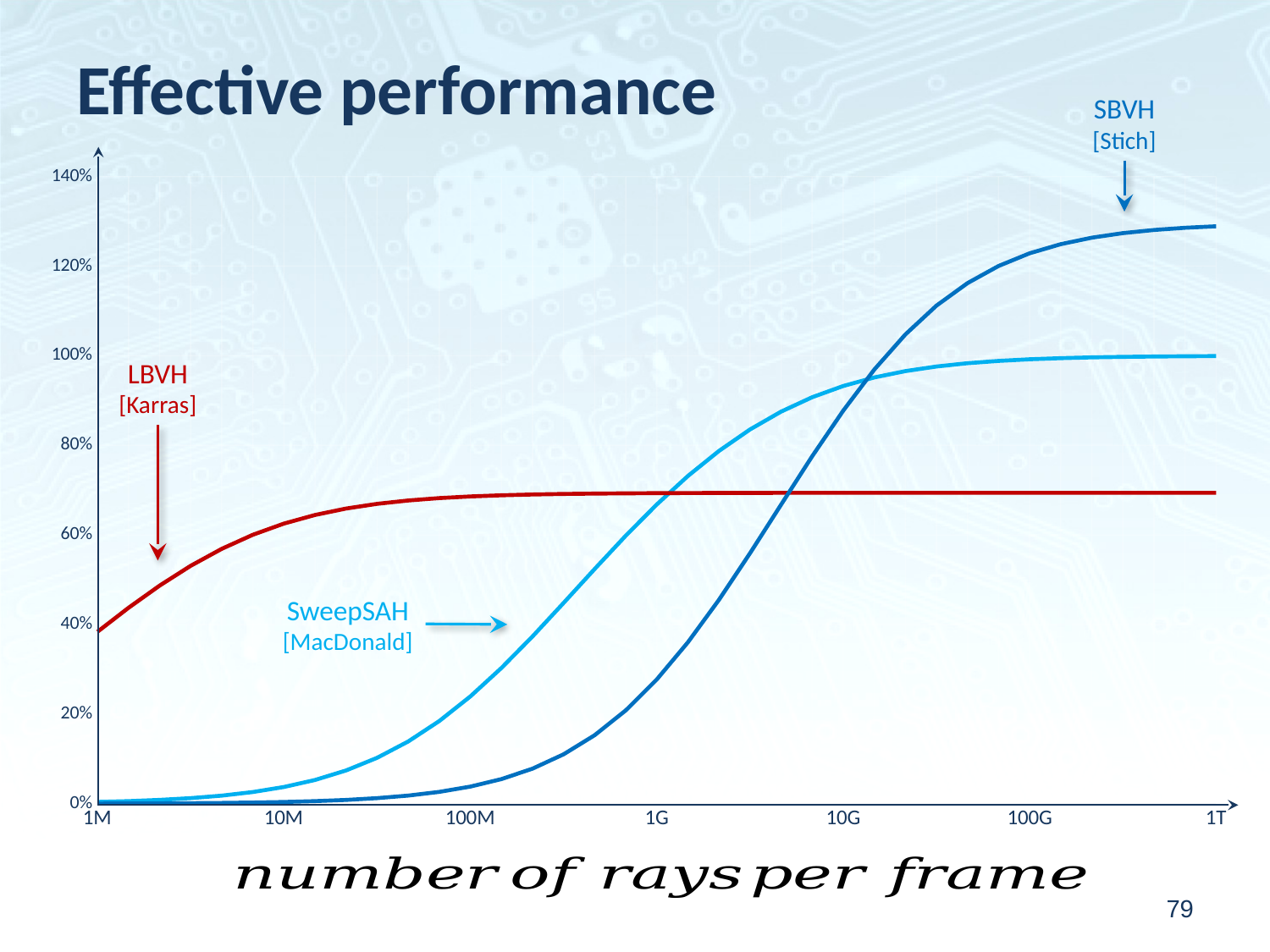
Is the value for LBVH [Karras] at 1T greater or less than 80%? less Is the value for SBVH [Stich] at 1T greater or less than 120%? greater What kind of chart is shown on the slide? line chart Is the value for LBVH [Karras] at 1M greater or less than 20%? greater At 1T rays per frame, which series has the higher value, SBVH [Stich] or LBVH [Karras]? SBVH [Stich] What is the label of the x axis? number of rays per frame What is the title of the chart? Effective performance How many tick labels are shown on the x axis? 7 How many series (curves) are plotted on the chart? 3 At 1M rays per frame, which series has the higher value, LBVH [Karras] or SweepSAH [MacDonald]? LBVH [Karras] Does the SBVH [Stich] curve rise or fall as the number of rays per frame increases? rise